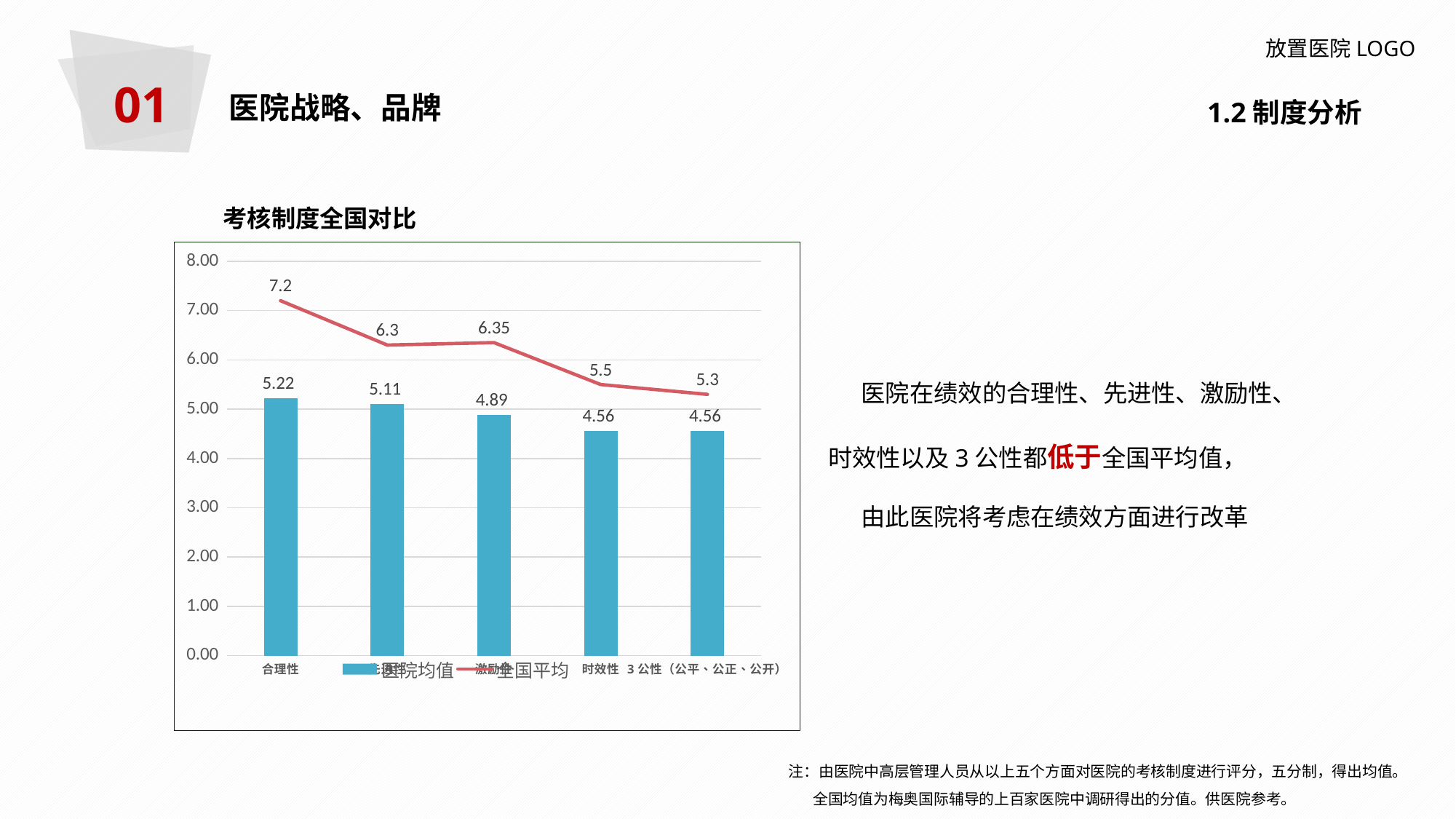
Do the 医院均值 values rise or fall from left to right along the x axis? Fall What is the 全国平均 value for 时效性? 5.5 What is the 全国平均 value for 合理性? 7.2 What is the 全国平均 value for 3公性（公平、公正、公开）? 5.3 Which is larger, the 医院均值 for 合理性 or the 医院均值 for 时效性? 合理性 How many series does the legend list? 2 How many categories are shown on the x axis? 5 What kind of chart is this? Combined bar and line chart What is the 医院均值 value for 合理性? 5.22 What is the 医院均值 value for 时效性? 4.56 Which category has the highest 全国平均 value? 合理性 What is the difference between the 全国平均 and 医院均值 values for 合理性? 1.98